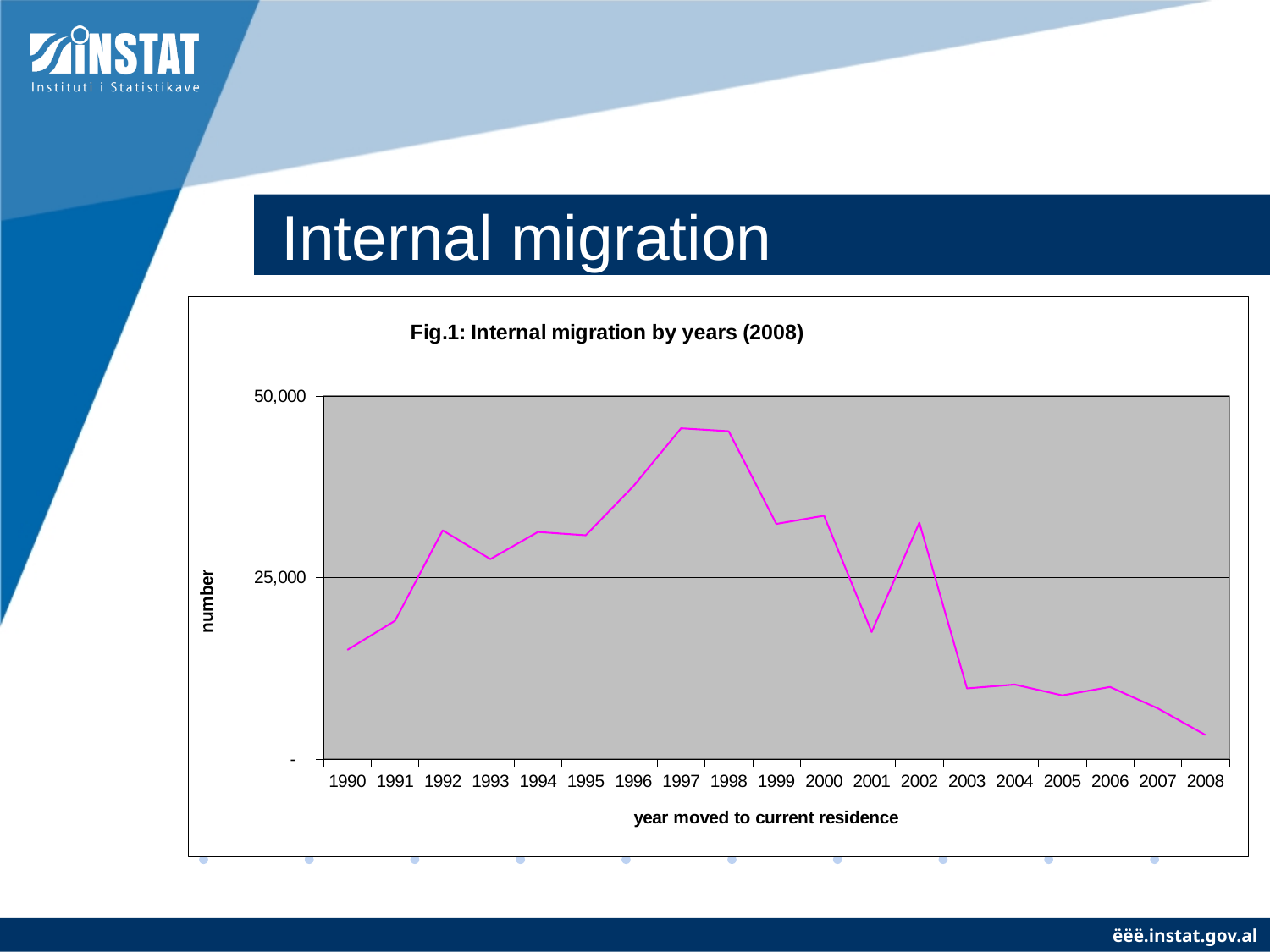
How many years are plotted on the x axis? 19 Which year has the lowest value? 2008 Is the value for 2003 greater or less than 25,000? less What is the title of the chart? Fig.1: Internal migration by years (2008) Which is larger, the value for 1990 or the value for 1992? 1992 Is the value for 1990 greater or less than 25,000? less What kind of chart is shown on the slide? line chart Is the value for 2002 greater or less than 25,000? greater Which is larger, the value for 1997 or the value for 2008? 1997 What is the label of the x axis? year moved to current residence Do the values rise or fall from 2003 to 2008? fall